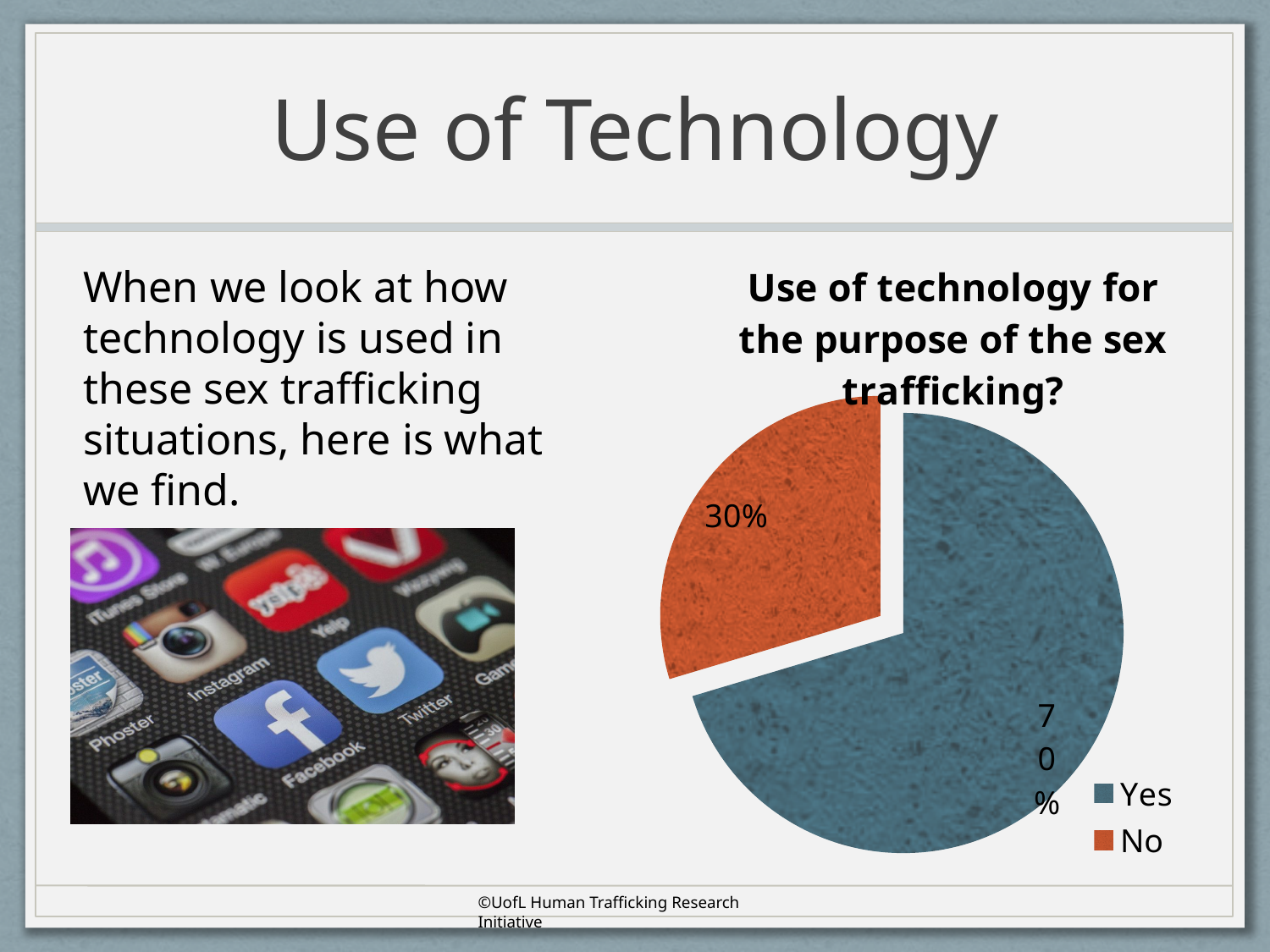
What share of the pie does the "No" slice represent? 30% How many entries does the legend list? 2 What colour is the "No" slice in the pie chart? orange Which slice is the smallest in the pie chart? No How many slices does the pie chart have? 2 Which is larger, the "Yes" slice or the "No" slice? Yes What is the difference in percentage points between the "Yes" and "No" slices? 40 What kind of chart is shown on the slide? pie chart Which slice is the largest in the pie chart? Yes What percentage of the pie is the "Yes" slice? 70% What percentage of the pie is the "No" slice? 30% What is the title of the chart? Use of technology for the purpose of the sex trafficking?